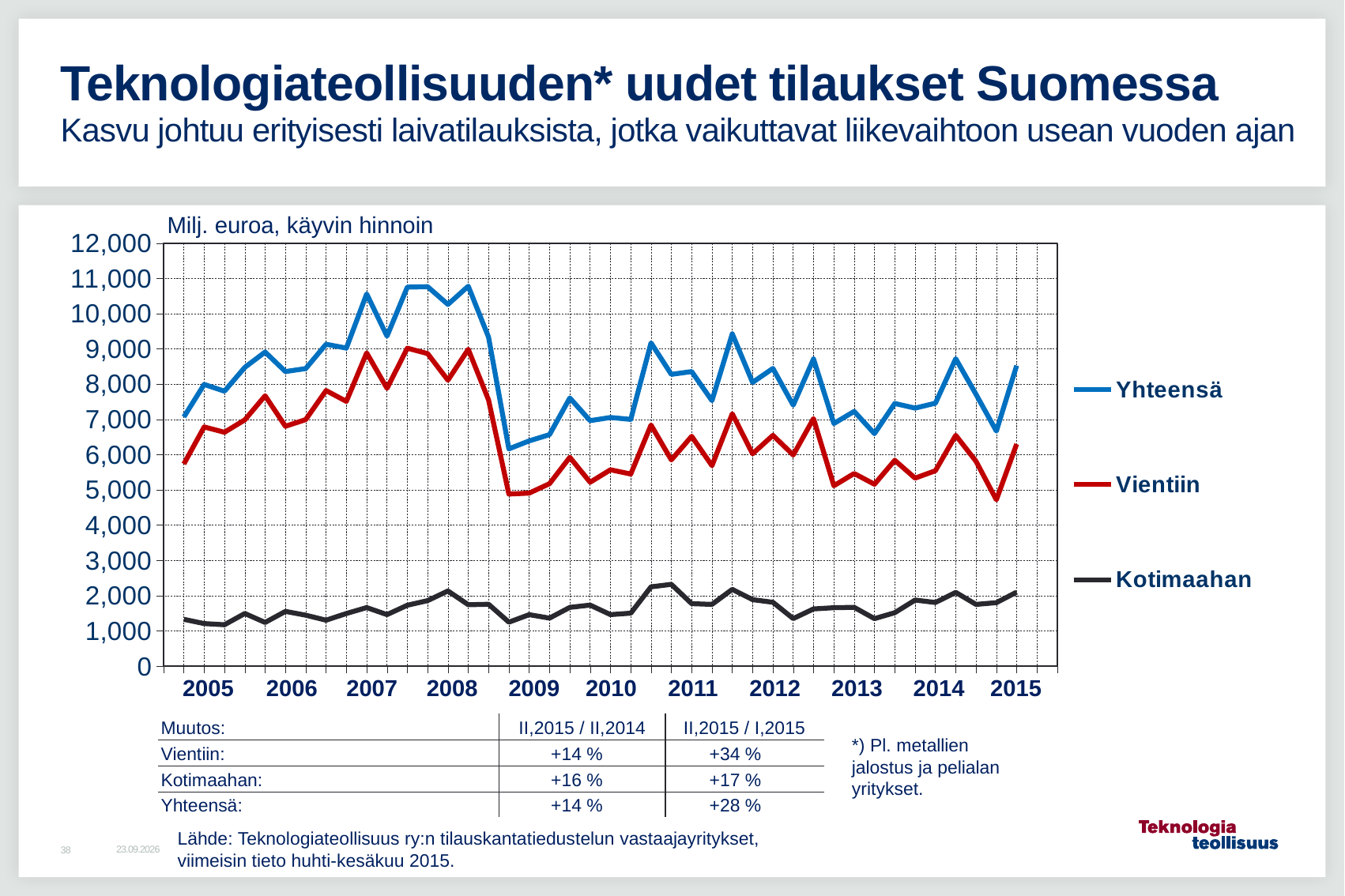
Is the peak value of the Yhteensä series in 2008 greater or less than 10,000? greater Is the last plotted value of the Yhteensä series in 2015 greater or less than 8,000? greater What unit label is shown above the y axis of the chart? Milj. euroa, käyvin hinnoin Which series has the highest values throughout the chart? Yhteensä How many series does the chart legend list? 3 Is the value of the Kotimaahan series at any point greater or less than 3,000? less Which series has the lowest values throughout the chart? Kotimaahan Does the Yhteensä series rise or fall between 2008 and 2009? fall How many years are labelled on the x axis? 11 Which series is higher in 2012, Vientiin or Kotimaahan? Vientiin What kind of chart is shown on the slide? line chart